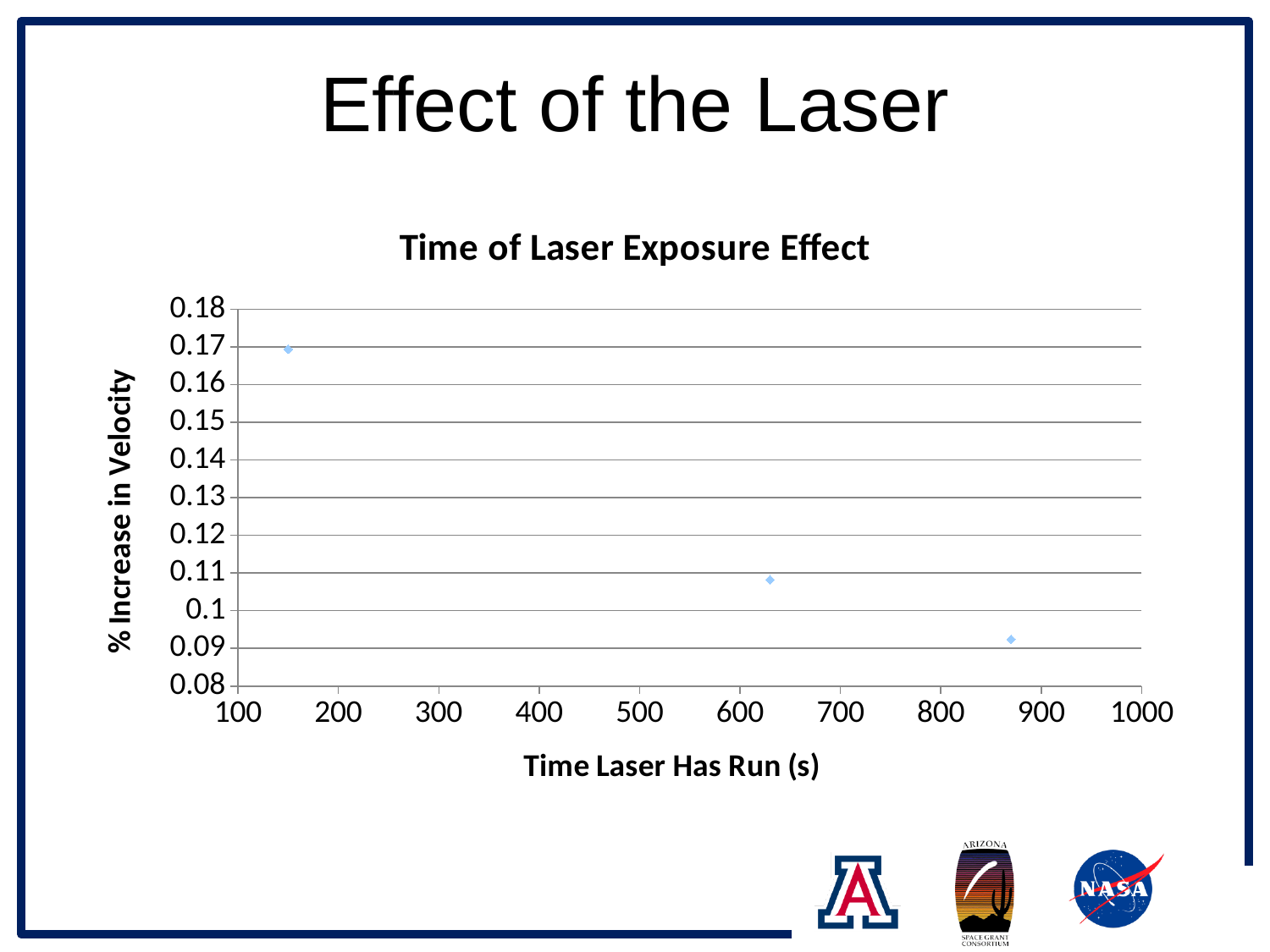
Is the % increase in velocity for the rightmost point (near 870 s) greater or less than 0.1? less Is the % increase in velocity for the leftmost point (near 150 s) greater or less than 0.16? greater Which point has the highest % increase in velocity: the leftmost, middle, or rightmost? leftmost Is the % increase in velocity for the middle point (near 630 s) greater or less than 0.1? greater Which point has the lowest % increase in velocity: the leftmost, middle, or rightmost? rightmost Do the plotted values rise or fall as the time the laser has run increases? fall What is the label of the x axis? Time Laser Has Run (s) What is the title of the chart? Time of Laser Exposure Effect What kind of chart is shown on the slide? scatter chart Which has a larger % increase in velocity, the point near 150 s or the point near 630 s? the point near 150 s How many data points are plotted on the chart? 3